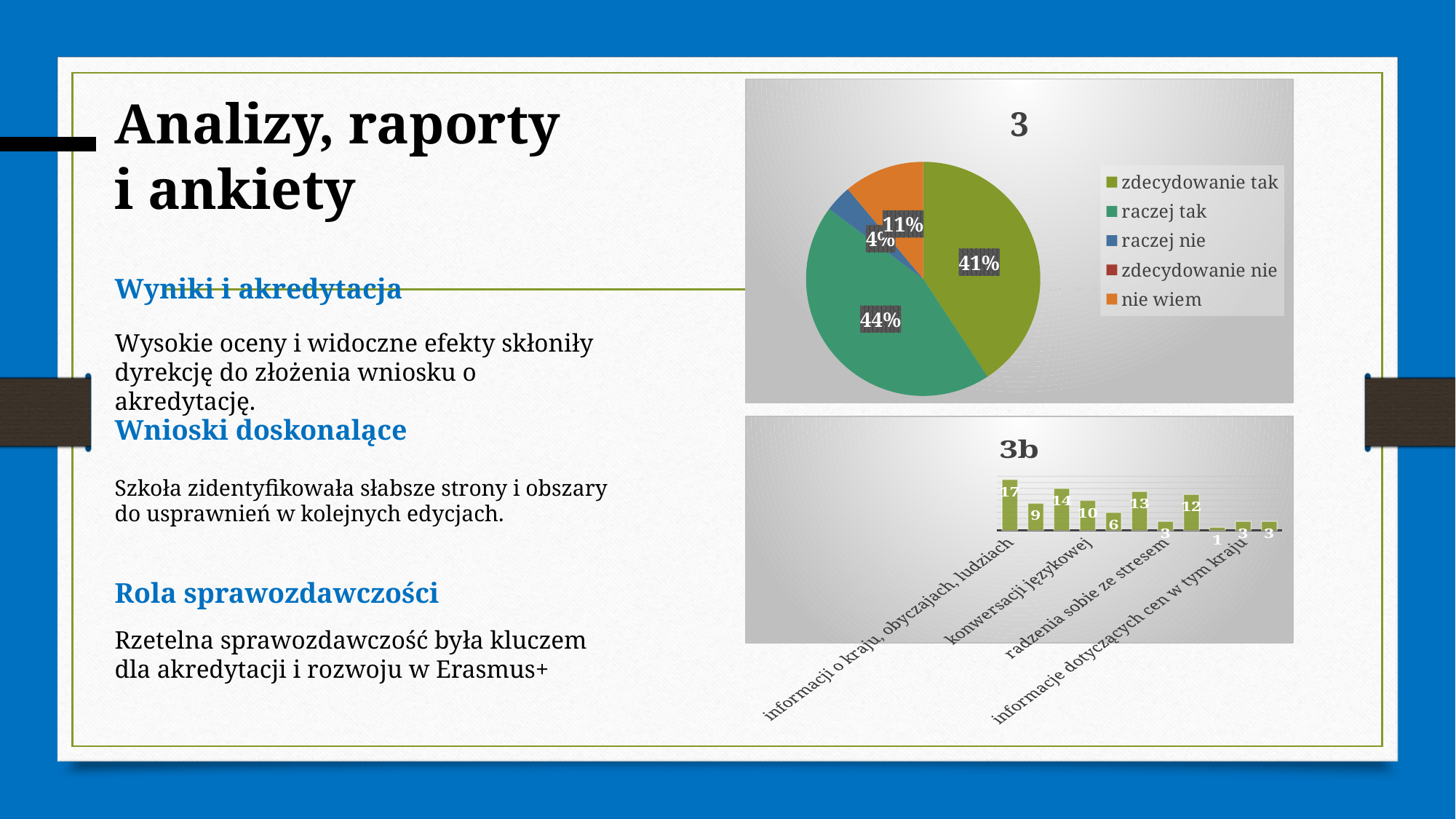
In the pie chart titled "3", which legend category has the largest slice? raczej tak In the pie chart titled "3", what share is labelled for "raczej nie"? 4% In the pie chart titled "3", what is the difference in percentage points between "raczej tak" and "zdecydowanie tak"? 3 In the pie chart titled "3", what share is labelled for "zdecydowanie tak"? 41% In the pie chart titled "3", what share is labelled for "nie wiem"? 11% In the pie chart titled "3", which is larger: the share for "nie wiem" or the share for "raczej nie"? nie wiem In the chart titled "3b", how many bars are plotted? 11 In the pie chart titled "3", what share is labelled for "raczej tak"? 44% In the chart titled "3b", what is the highest value shown on a bar? 17 What kind of chart is the chart titled "3b"? bar chart In the chart titled "3b", what is the lowest value shown on a bar? 1 In the pie chart titled "3", how many entries does the legend list? 5